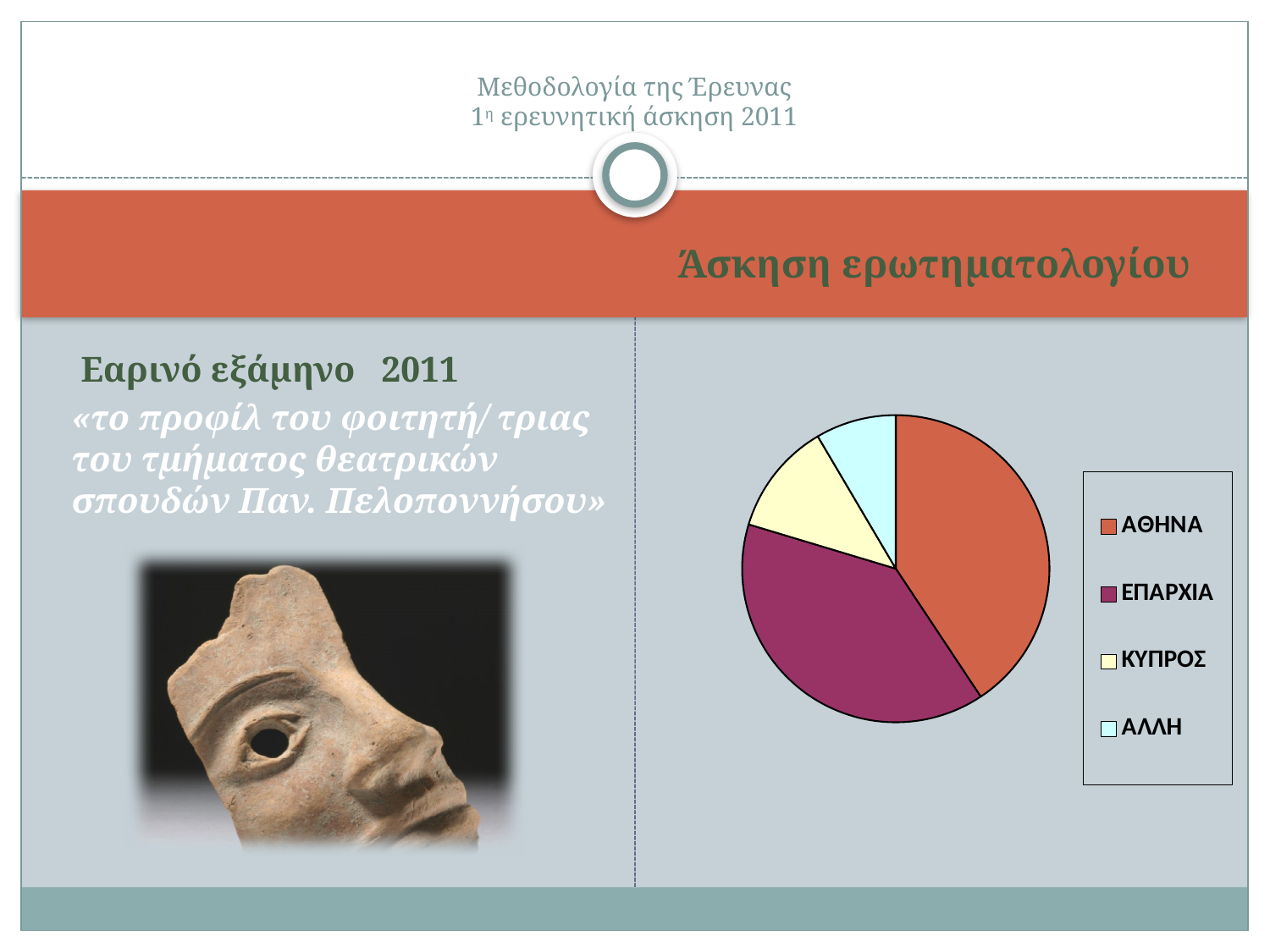
Which category has the largest slice of the pie chart? ΑΘΗΝΑ Which slice is larger, ΚΥΠΡΟΣ or ΑΛΛΗ? ΚΥΠΡΟΣ What colour is the ΕΠΑΡΧΙΑ slice in the pie chart? purple Which category has the smallest slice of the pie chart? ΑΛΛΗ Which category is shown in orange in the pie chart? ΑΘΗΝΑ How many entries does the legend of the pie chart list? 4 How many slices does the pie chart have? 4 Which slice is larger, ΕΠΑΡΧΙΑ or ΚΥΠΡΟΣ? ΕΠΑΡΧΙΑ Which slice is larger, ΑΘΗΝΑ or ΕΠΑΡΧΙΑ? ΑΘΗΝΑ What kind of chart is shown on the slide? pie chart